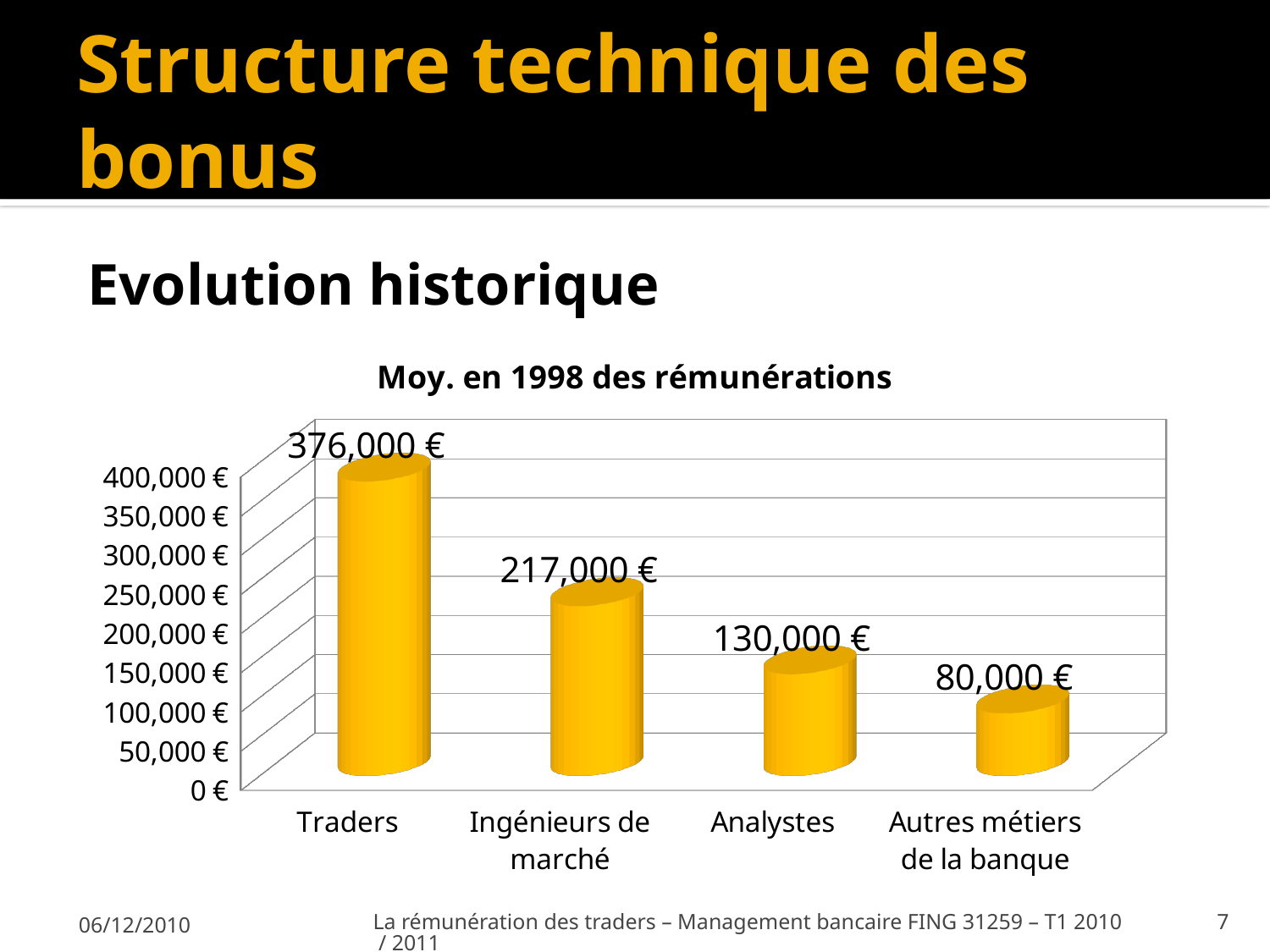
What kind of chart is shown on the slide? Bar chart Which category has the highest value? Traders What is the difference between the values for Traders and Ingénieurs de marché? 159,000 € What is the title of the chart? Moy. en 1998 des rémunérations Which is larger, the value for Ingénieurs de marché or the value for Analystes? Ingénieurs de marché What is the value for Traders? 376,000 € How many categories are shown on the chart? 4 What is the value for Ingénieurs de marché? 217,000 € What is the value for Autres métiers de la banque? 80,000 € Which category has the lowest value? Autres métiers de la banque What is the difference between the values for Analystes and Autres métiers de la banque? 50,000 € What is the value for Analystes? 130,000 €